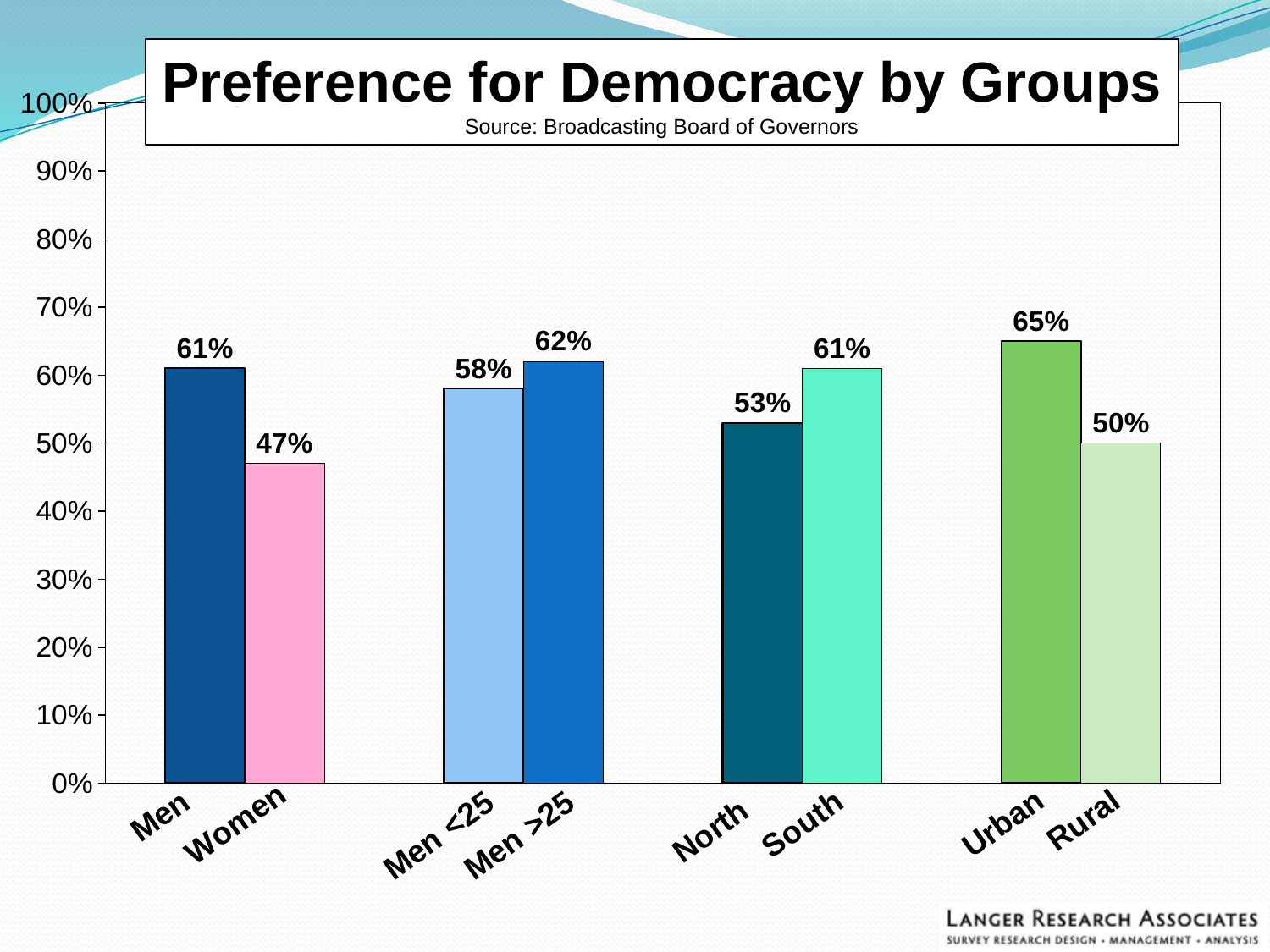
What is the value for Men? 61% How many groups are shown on the chart? 8 What is the value for North? 53% What kind of chart is this? Bar chart What is the value for Women? 47% What is the value for Men >25? 62% Which group has the lowest value? Women Which group has the highest value? Urban What is the value for Rural? 50% What is the difference between the values for Men and Women? 14% Which is larger, the value for North or the value for South? South What is the title of the chart? Preference for Democracy by Groups